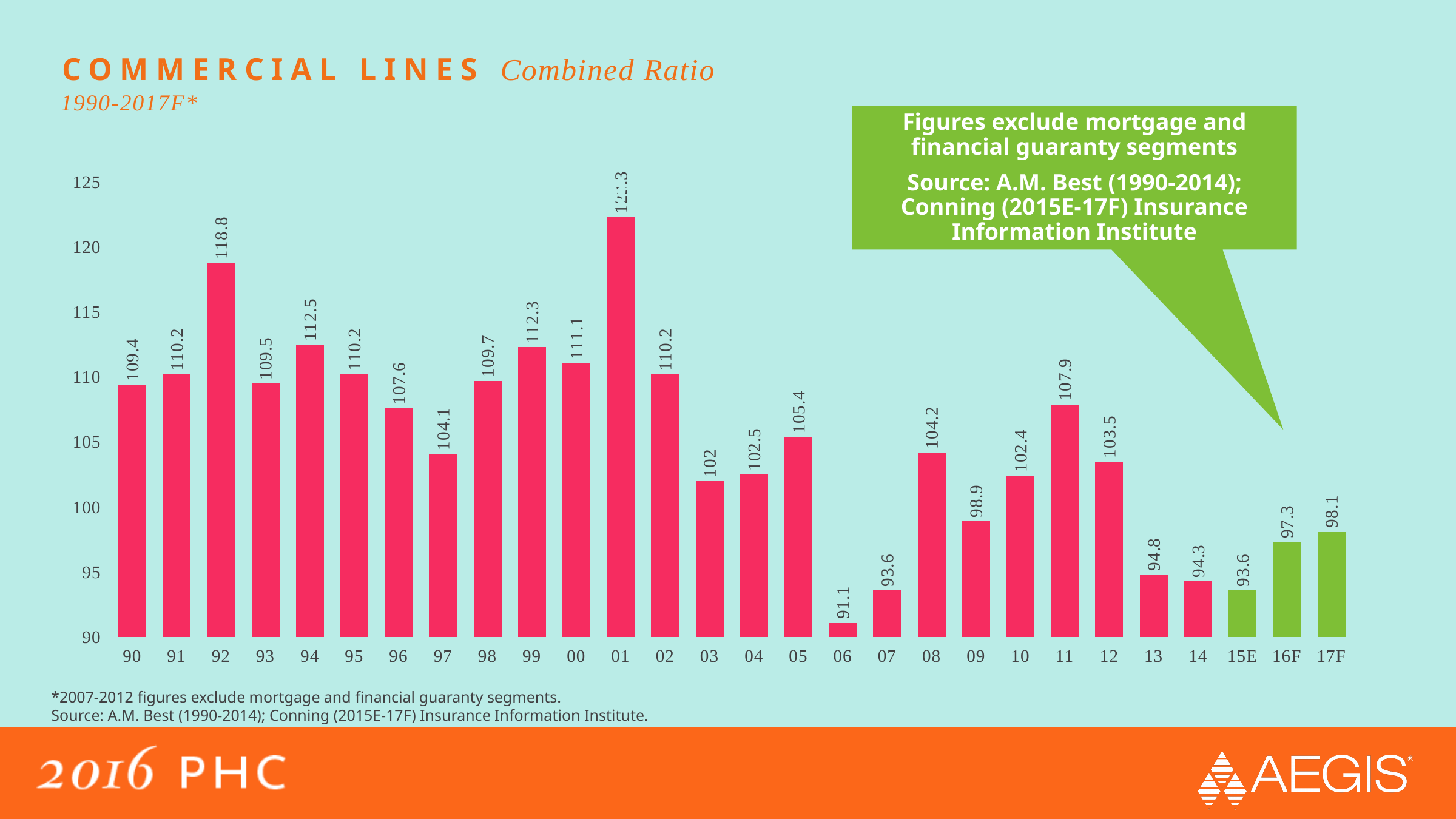
Which year has the lowest combined ratio? 06 What is the difference between the combined ratio for 17F and for 16F? 0.8 Do the combined ratio values rise or fall from 11 to 14? fall Which year has the highest combined ratio? 01 What is the combined ratio forecast for 17F? 98.1 What is the combined ratio for 06? 91.1 How many bars are shown in the chart? 28 What kind of chart is shown on the slide? bar chart What is the combined ratio for 92? 118.8 What is the difference between the combined ratio for 92 and for 93? 9.3 Is the combined ratio for 09 greater or less than 100? less Which has a higher combined ratio, 11 or 12? 11